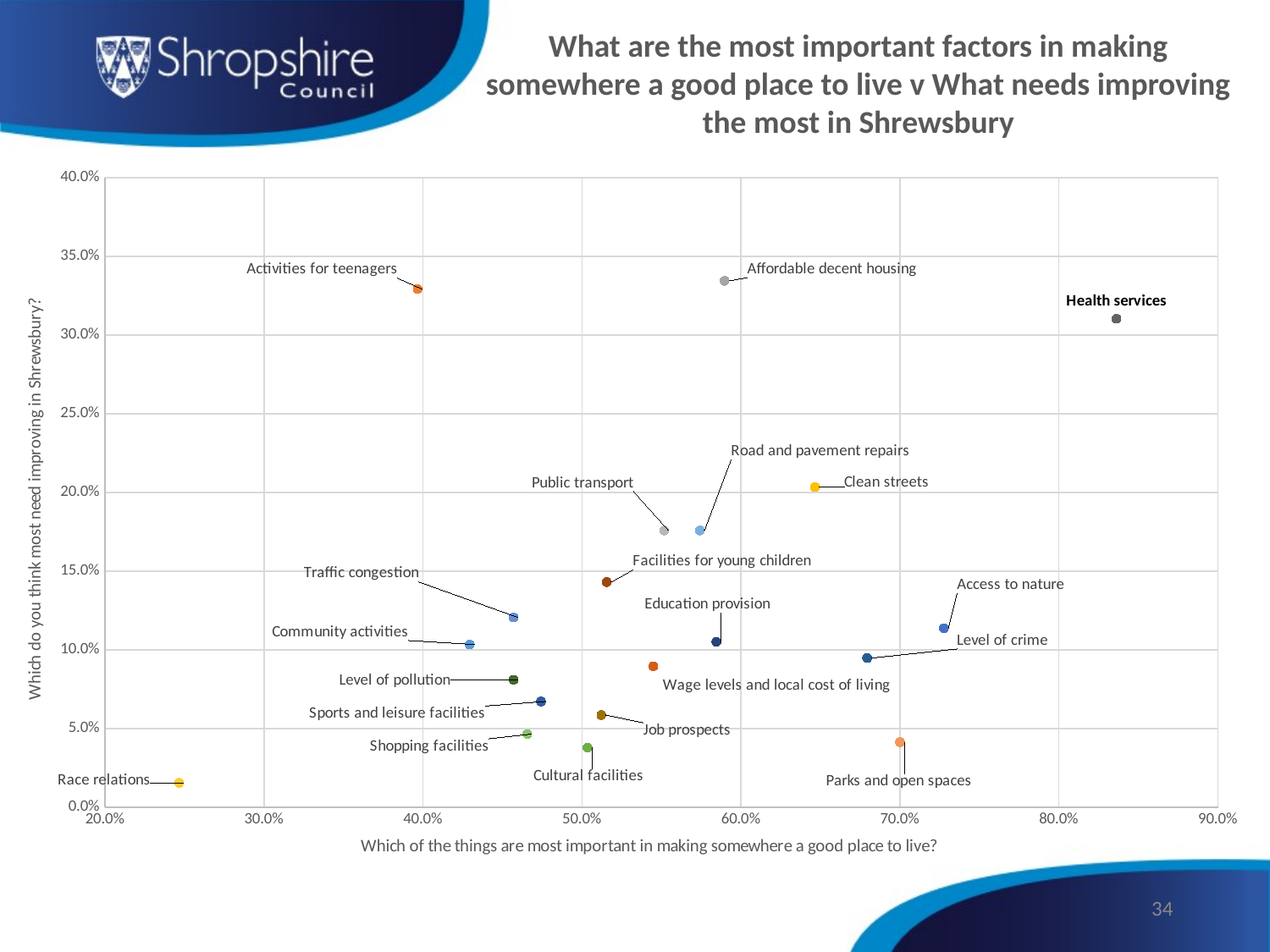
Is the vertical-axis value for Health services greater or less than 30.0%? greater Is the vertical-axis value for Public transport greater or less than 20.0%? less Is the horizontal-axis value for Health services greater or less than 80.0%? greater What is the title of the horizontal axis? Which of the things are most important in making somewhere a good place to live? Which has the higher vertical-axis value, Clean streets or Public transport? Clean streets Which factor has the lowest value on the horizontal axis? Race relations Which factor has the lowest value on the vertical axis (most need improving in Shrewsbury)? Race relations What kind of chart is shown on the slide? Scatter chart How many labelled data points are plotted on the chart? 20 Which factor has the highest value on the horizontal axis (most important in making somewhere a good place to live)? Health services